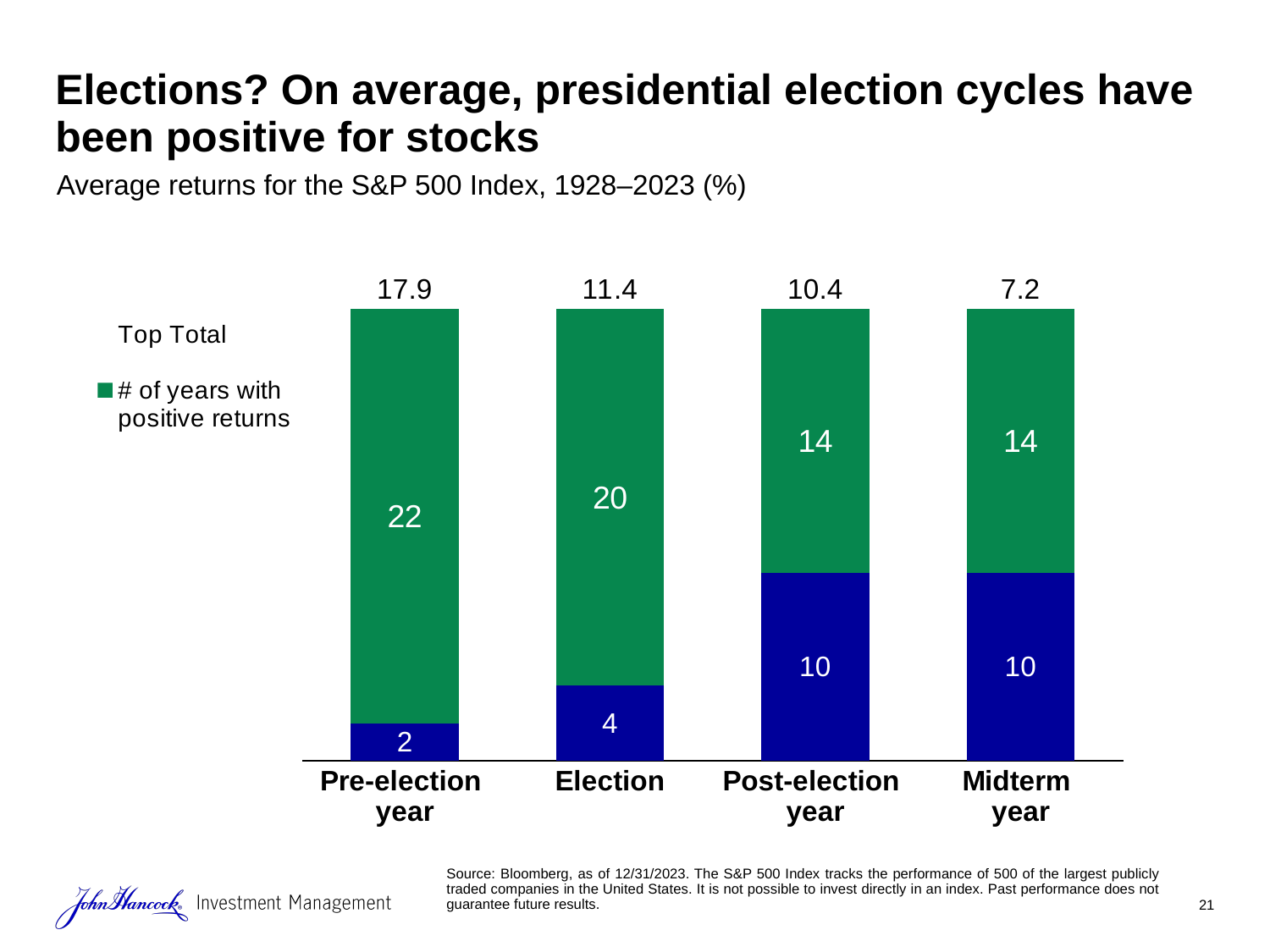
How many categories are shown on the x axis? 4 Which category has the highest average return printed above its bar? Pre-election year What is the total of the two stacked segments in the Pre-election year bar? 24 What kind of chart is shown on the slide? Stacked bar chart What is the average return shown above the Pre-election year bar? 17.9 How many more years with positive returns does the Pre-election year have than the Midterm year? 8 What value is printed in the blue segment of the Post-election year bar? 10 How many years with positive returns are shown for the Election year? 20 Which has more years with positive returns, the Election year or the Post-election year? Election Which category has the lowest average return printed above its bar? Midterm year Do the average returns printed above the bars rise or fall from left to right? Fall What is the difference between the average returns for the Pre-election year and the Midterm year? 10.7